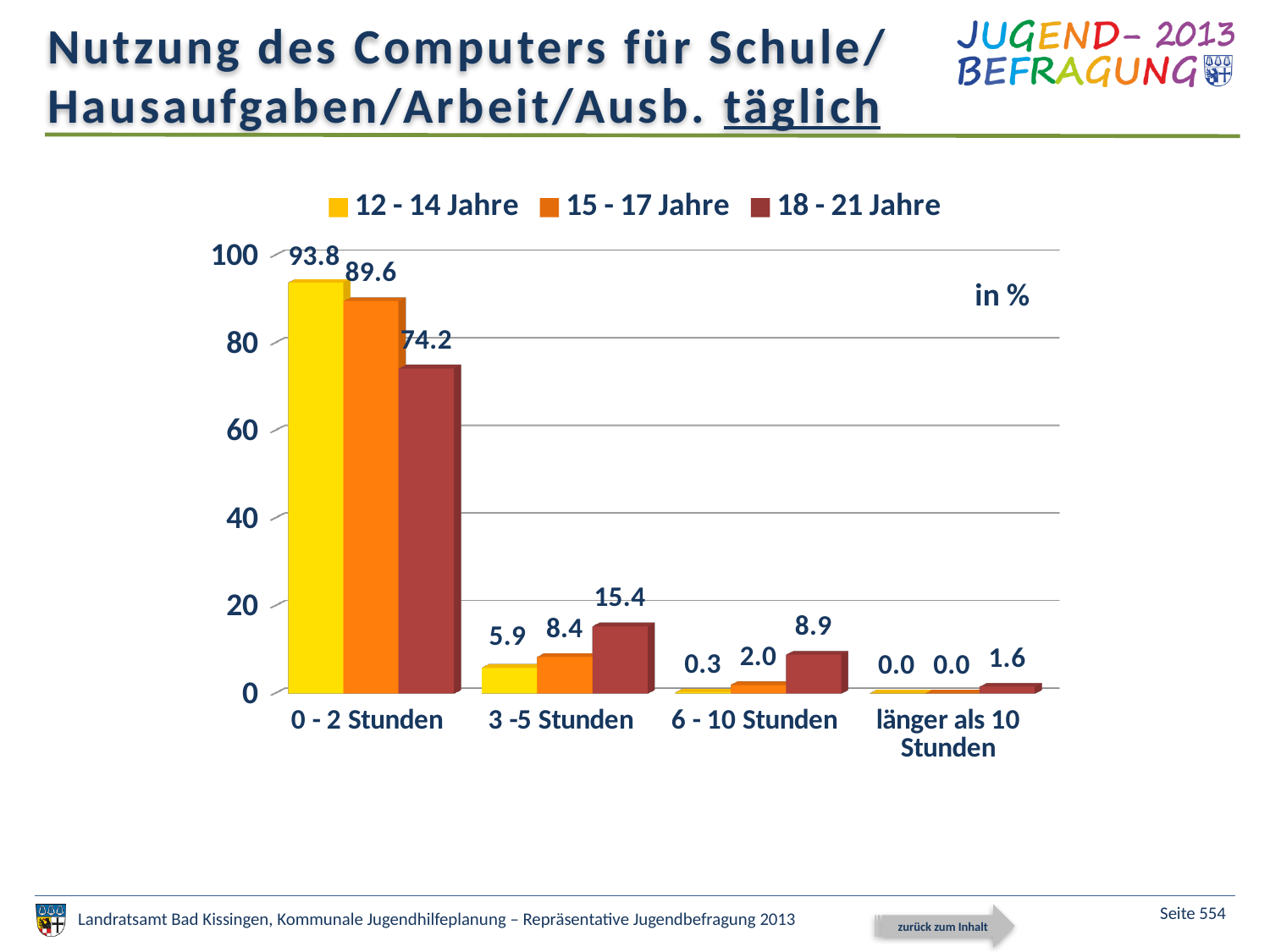
What kind of chart is shown on the slide? bar chart What is the value for 18 - 21 Jahre in the 3 -5 Stunden category? 15.4 Which is larger in the 3 -5 Stunden category: the value for 15 - 17 Jahre or for 18 - 21 Jahre? 18 - 21 Jahre What is the value for 15 - 17 Jahre in the 6 - 10 Stunden category? 2.0 What is the difference between the 12 - 14 Jahre and 18 - 21 Jahre values in the 0 - 2 Stunden category? 19.6 Which age group has the lowest value in the 6 - 10 Stunden category? 12 - 14 Jahre Is the value for 15 - 17 Jahre in the 0 - 2 Stunden category greater or less than 80? greater Which age group has the highest value in the 0 - 2 Stunden category? 12 - 14 Jahre How many categories are shown on the x axis? 4 How many series does the legend list? 3 What is the value for 12 - 14 Jahre in the 0 - 2 Stunden category? 93.8 What is the value for 18 - 21 Jahre in the länger als 10 Stunden category? 1.6